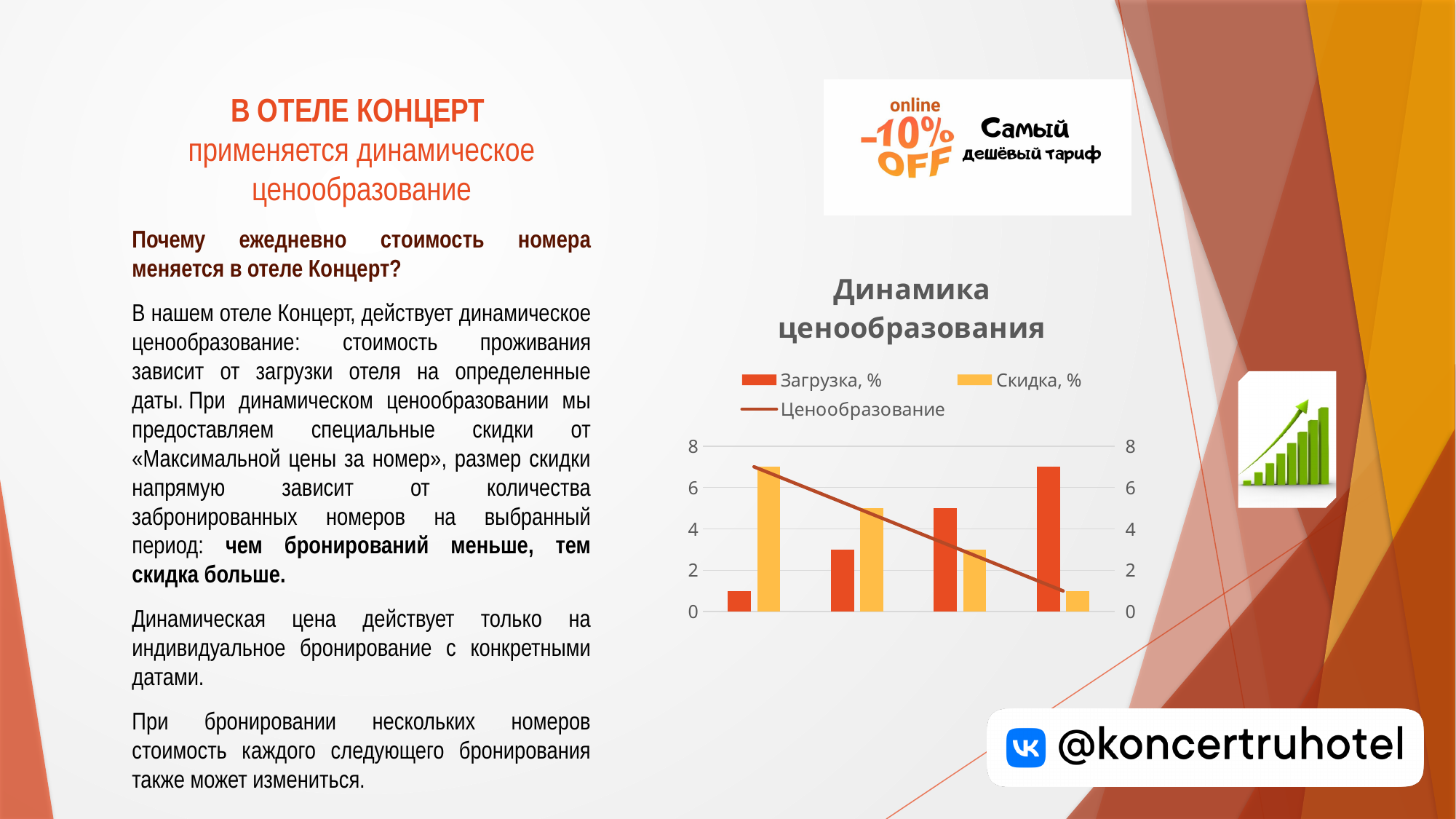
In the "Динамика ценообразования" chart, is the "Загрузка, %" value in the leftmost group greater or less than 2? less In the "Динамика ценообразования" chart, do the values of the "Скидка, %" series rise or fall from left to right? fall How many groups of bars are plotted in the "Динамика ценообразования" chart? 4 What is the highest value shown on the vertical axis of the "Динамика ценообразования" chart? 8 In the "Динамика ценообразования" chart, do the values of the "Загрузка, %" series rise or fall from left to right? rise In the "Динамика ценообразования" chart, is the "Скидка, %" value in the leftmost group greater or less than 6? greater What kind of chart is shown under the title "Динамика ценообразования"? combination bar and line chart In the "Динамика ценообразования" chart, which series has the taller bar in the leftmost group, "Загрузка, %" or "Скидка, %"? Скидка, % In the "Динамика ценообразования" chart, which group of bars has the highest "Загрузка, %" value? the rightmost (fourth) group In the "Динамика ценообразования" chart, is the "Загрузка, %" value in the rightmost group greater or less than 6? greater How many series does the legend of the "Динамика ценообразования" chart list? 3 In the "Динамика ценообразования" chart, does the "Ценообразование" line rise or fall from left to right? fall